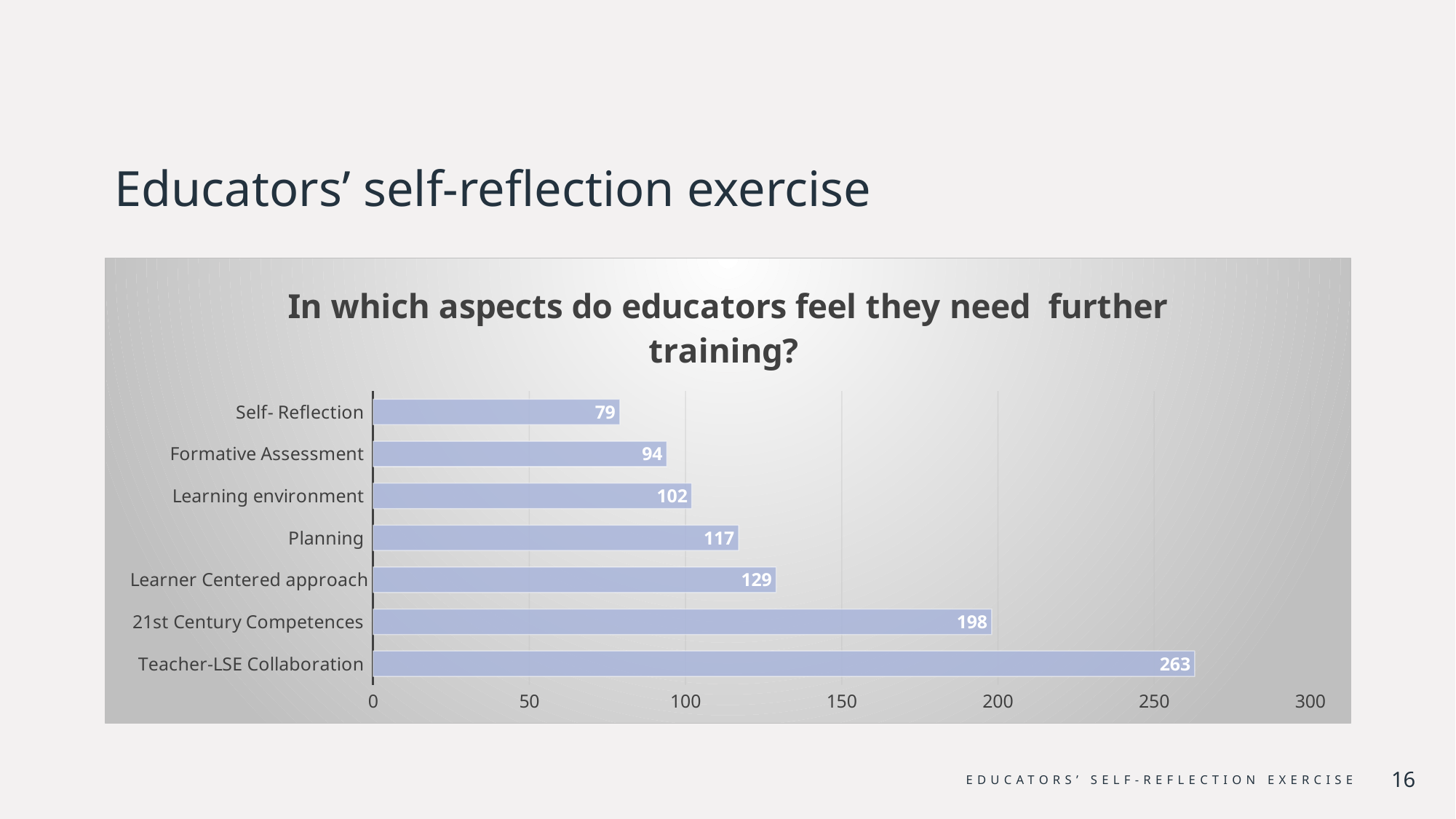
What kind of chart is shown on the slide? Bar chart What is the difference between the values for Teacher-LSE Collaboration and 21st Century Competences? 65 What is the value for Formative Assessment? 94 How many categories are shown in the chart? 7 Which category has the lowest value? Self- Reflection Is the value for 21st Century Competences greater or less than 150? greater What is the difference between the values for Learner Centered approach and Learning environment? 27 What is the value for Planning? 117 Which category has the highest value? Teacher-LSE Collaboration What is the title of the chart? In which aspects do educators feel they need further training? What is the value for Teacher-LSE Collaboration? 263 Which is larger, the value for Planning or the value for Formative Assessment? Planning